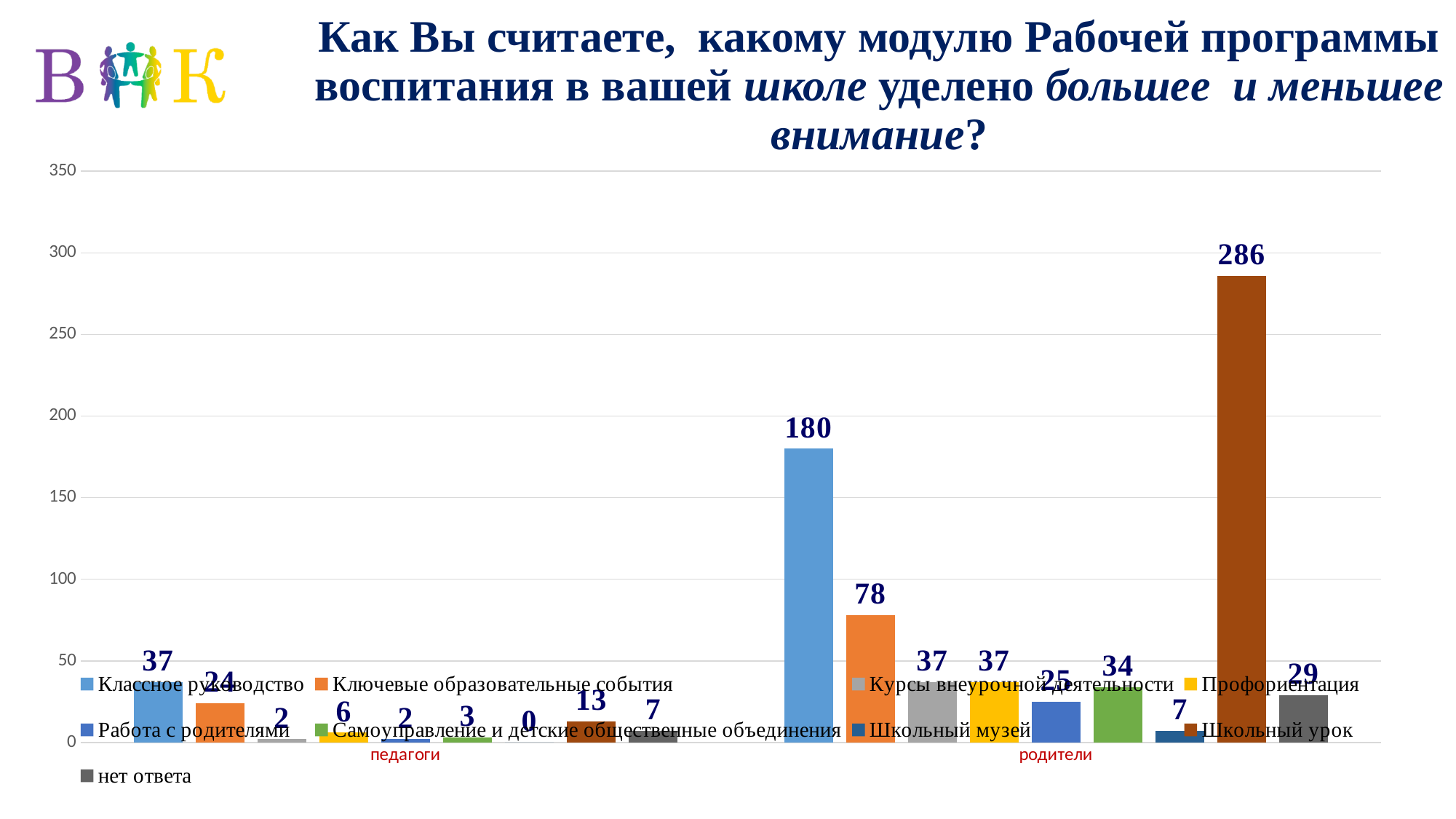
What is the value for Ключевые образовательные события in the родители category? 78 How many categories are shown on the x axis? 2 What type of chart is shown on the slide? bar chart Which is larger in the педагоги category: Ключевые образовательные события or Школьный урок? Ключевые образовательные события Which series has the highest value in the родители category? Школьный урок What colour are the bars for Школьный урок? brown Which series has the lowest value in the педагоги category? Школьный музей What is the value for Классное руководство in the педагоги category? 37 How many series does the legend list? 9 What is the value for нет ответа in the родители category? 29 What is the value for Школьный урок in the родители category? 286 What is the difference between Школьный урок and Классное руководство in the родители category? 106